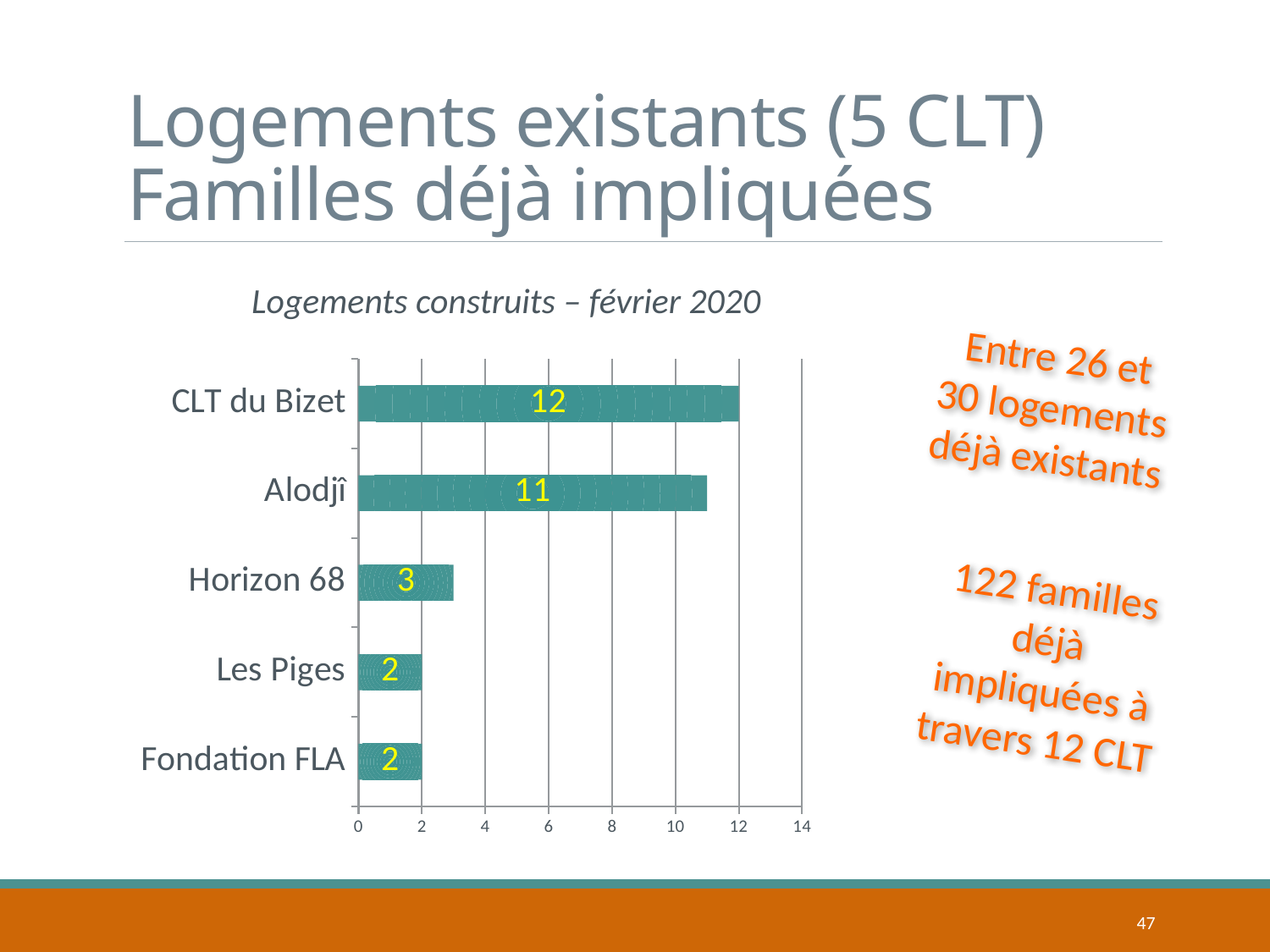
What is the value for CLT du Bizet? 12 What is the difference between the values for CLT du Bizet and Alodjî? 1 Which category has the highest value? CLT du Bizet What is the difference between the values for Alodjî and Horizon 68? 8 What is the title of the chart? Logements construits – février 2020 What is the value for Les Piges? 2 What is the value for Alodjî? 11 What kind of chart is shown on the slide? bar chart How many categories are shown in the chart? 5 Which is larger, the value for Horizon 68 or the value for Les Piges? Horizon 68 Is the value for Alodjî greater or less than 10? greater What is the value for Horizon 68? 3